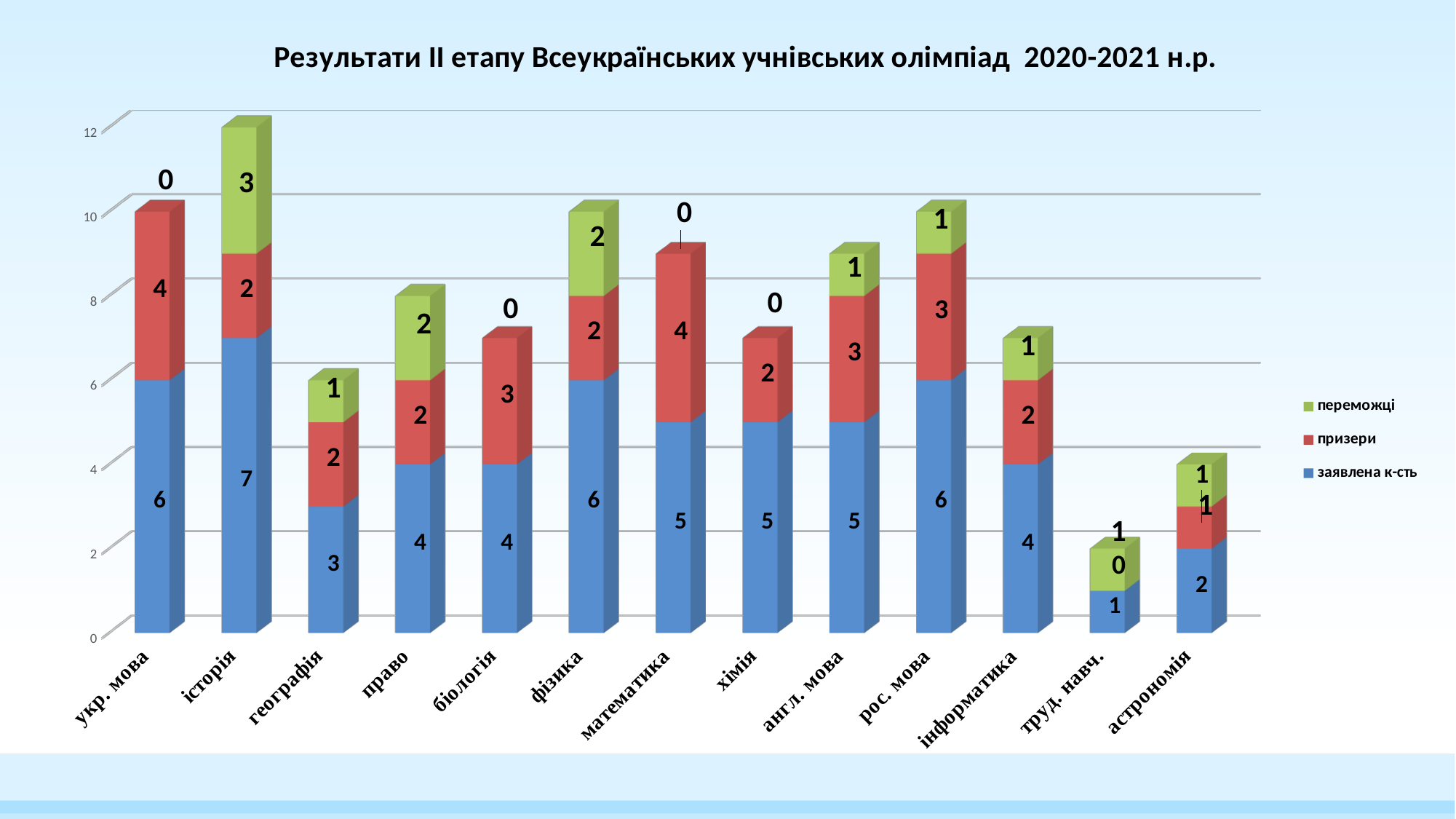
Which subject has the shortest stacked bar overall? труд. навч. What is the value of 'призери' for математика? 4 How many series does the legend list? 3 Which is larger: the 'призери' value for біологія or for хімія? біологія What is the difference between the 'заявлена к-сть' values for укр. мова and географія? 3 Which subject has the tallest stacked bar overall? історія What is the value of 'заявлена к-сть' for історія? 7 Which series is shown in green in the legend? переможці How many subject categories are shown on the x axis? 13 What is the total of the stacked bar for рос. мова? 10 What is the value of 'переможці' for фізика? 2 What type of chart is shown on the slide? stacked bar chart